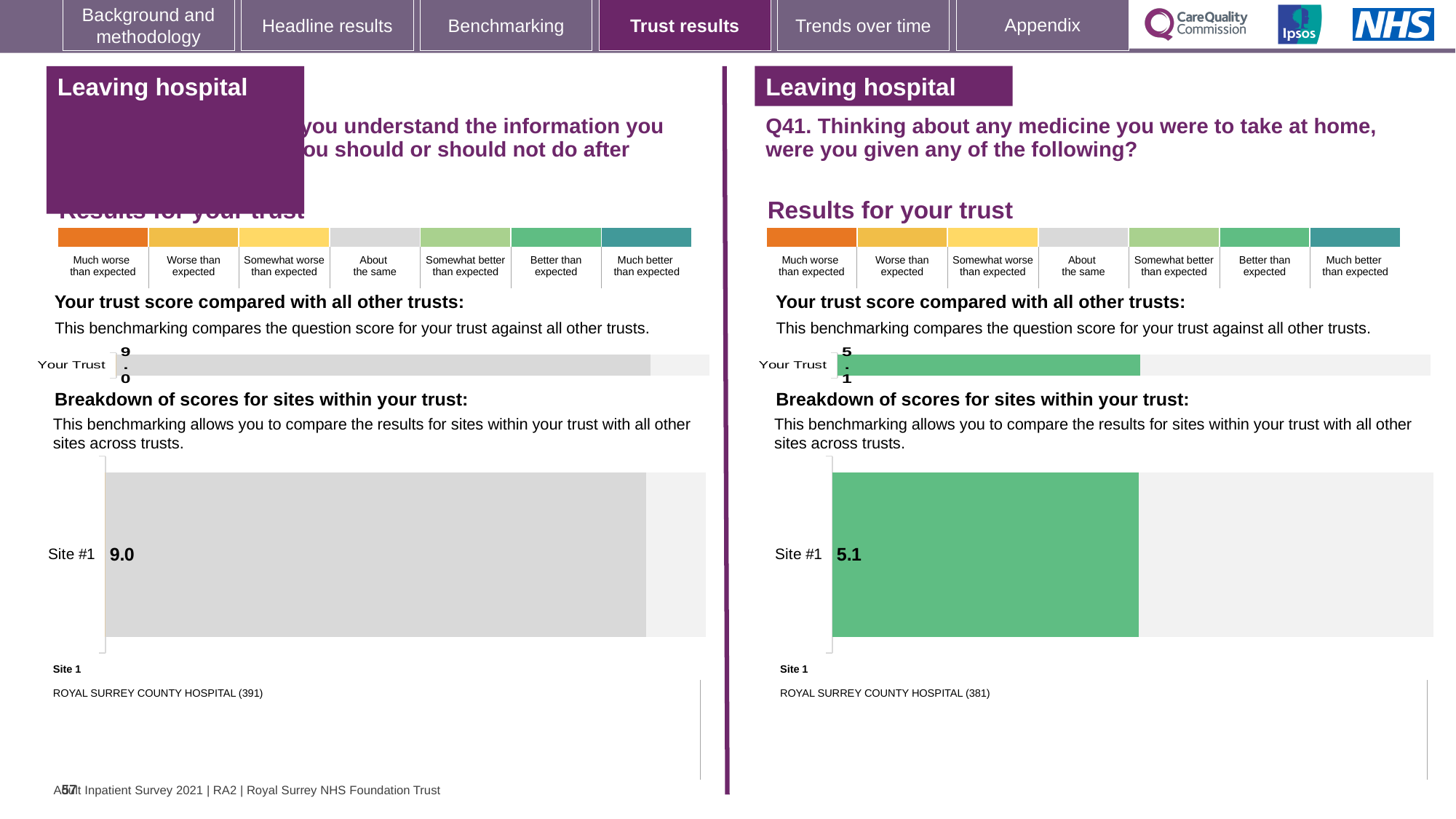
How many sites are shown in the site breakdown chart on the right-hand panel (Q41)? 1 On the left-hand panel's site breakdown chart, what is the score for Site #1? 9.0 What is the difference between the Site #1 score on the left-hand panel and the Site #1 score on the right-hand panel (Q41)? 3.9 On the right-hand panel (Q41), what colour is the Site #1 bar? green On the left-hand panel, what colour is the Site #1 bar? grey On the right-hand panel (Q41), what is the score shown for Your Trust? 5.1 On the left-hand panel, what is the score shown for Your Trust? 9.0 How many sites are shown in the site breakdown chart on the left-hand panel? 1 On the right-hand panel's (Q41) site breakdown chart, what is the score for Site #1? 5.1 What kind of chart is used to show the Site #1 score on the right-hand panel (Q41)? bar chart Which hospital is listed as Site 1 on the right-hand panel (Q41)? ROYAL SURREY COUNTY HOSPITAL (381) Which panel shows the higher Your Trust score, the left-hand panel or the right-hand panel (Q41)? the left-hand panel